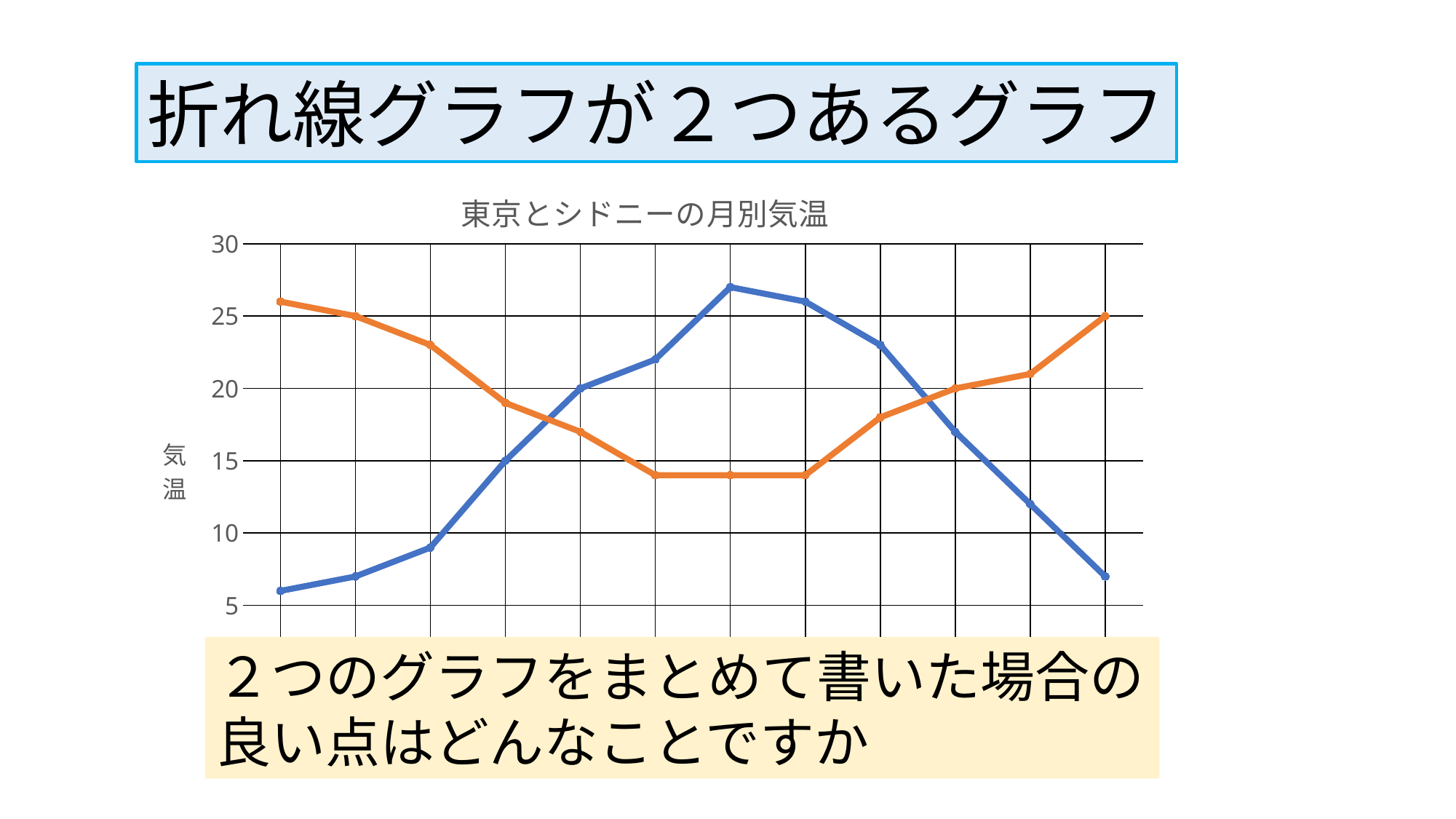
How many data points does each line on the chart have? 12 What is the title of the chart? 東京とシドニーの月別気温 Over the first four points from the left, does the blue line rise or fall? rise How many lines are plotted on the chart? 2 At the leftmost point, which line is higher, the blue line or the orange line? orange line At the rightmost point, which line is higher, the blue line or the orange line? orange line What is the label on the vertical axis of the chart? 気温 Is the lowest point of the orange line greater or less than 15? less Is the highest point of the blue line greater or less than 25? greater What kind of chart is shown on the slide? line chart Over the first four points from the left, does the orange line rise or fall? fall Is the leftmost point of the blue line greater or less than 10? less